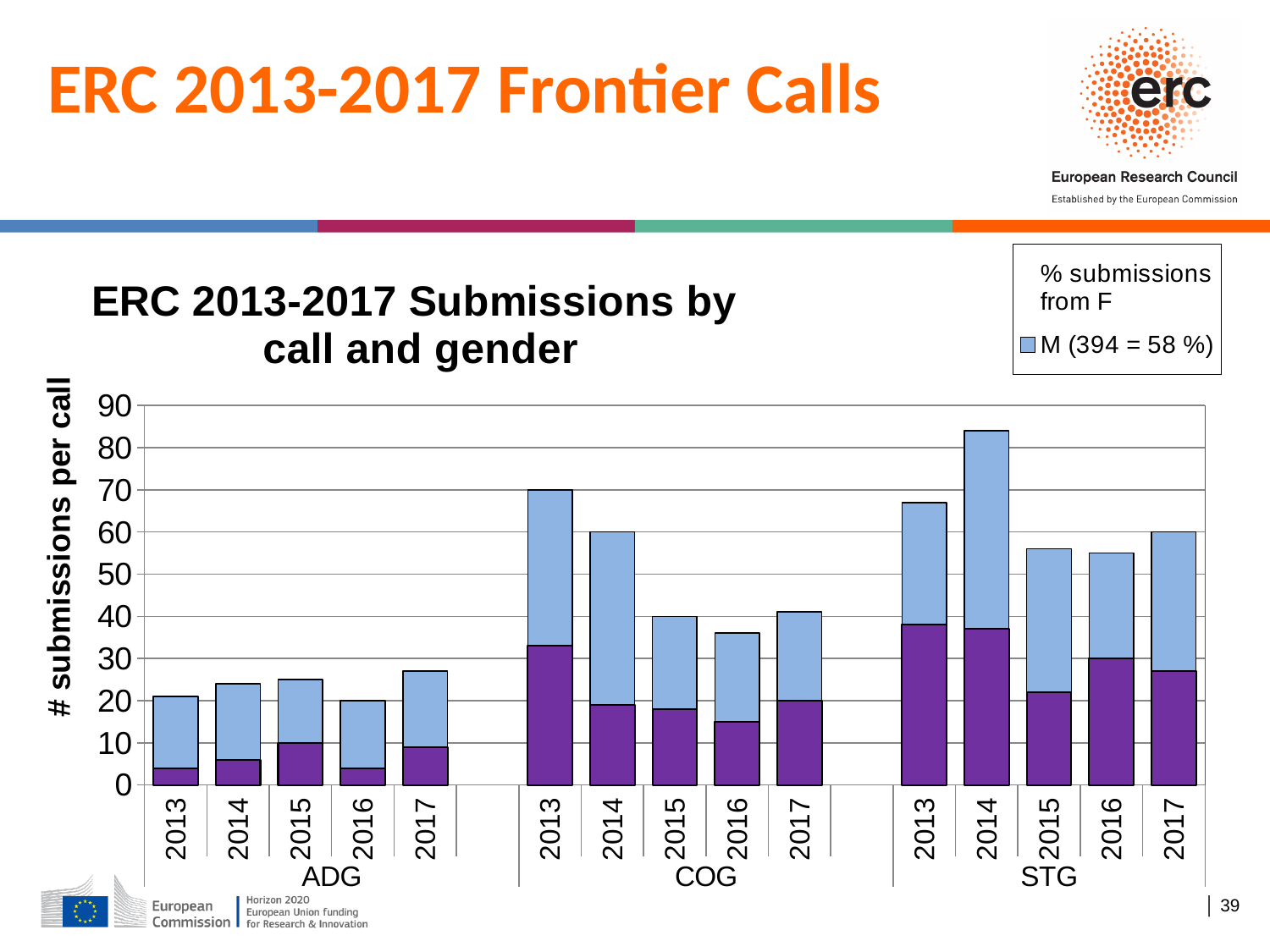
Which has the larger total, COG 2013 or COG 2014? COG 2013 Which bar has the highest total submissions? STG 2014 Is the total for ADG 2017 greater or less than 30? less What kind of chart is shown on the slide? Stacked bar chart Which has the larger total, STG 2014 or STG 2015? STG 2014 What is the label on the vertical axis of the chart? # submissions per call What is the title of the chart? ERC 2013-2017 Submissions by call and gender How many bars are plotted in the chart? 15 Is the total for COG 2016 greater or less than 40? less How many call groups (ADG, COG, STG) are shown on the x axis? 3 Is the total for STG 2014 greater or less than 80? greater How many series does the legend list? 2